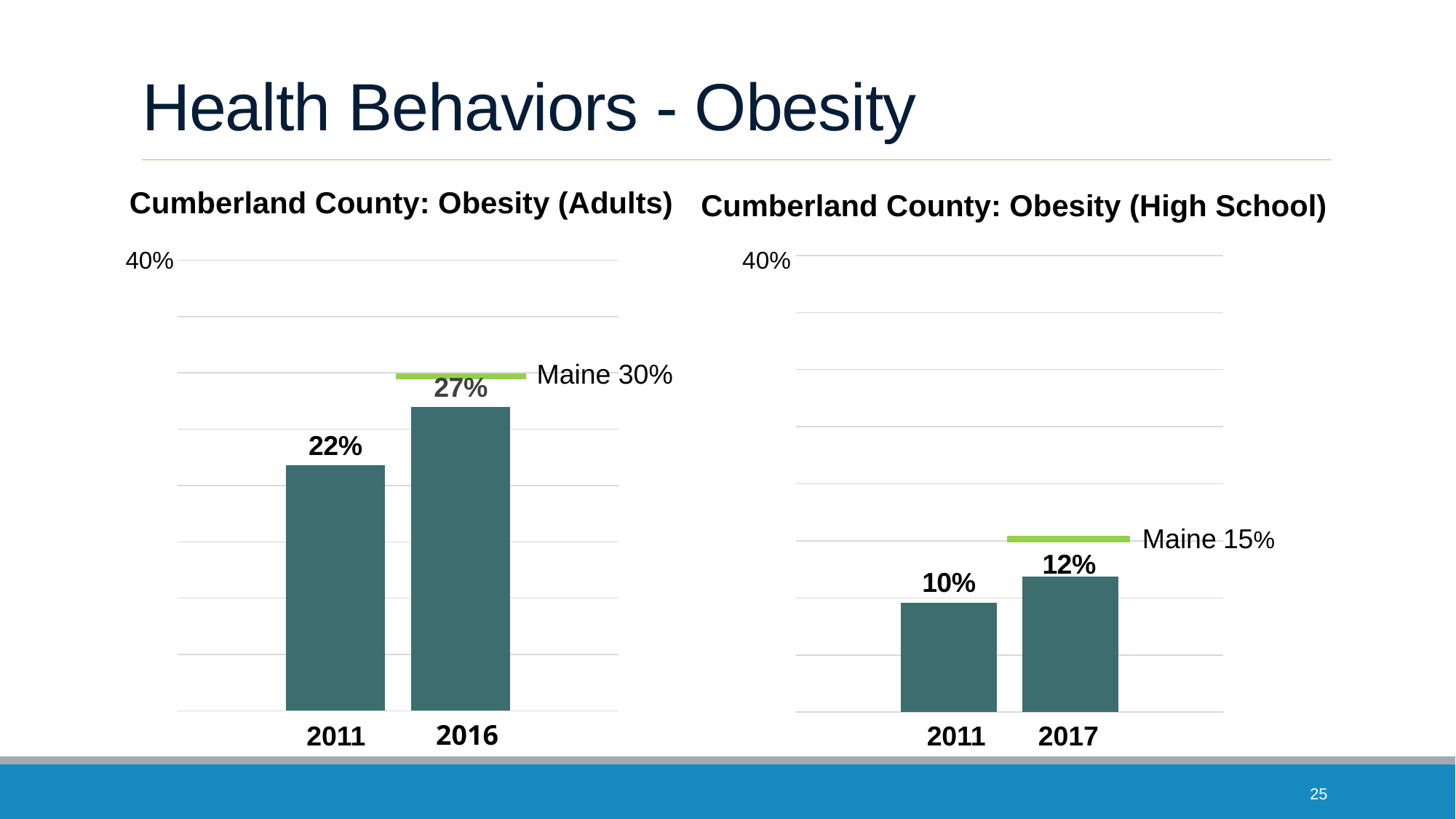
In the 'Cumberland County: Obesity (Adults)' chart, what is the value for 2016? 27% In the 'Cumberland County: Obesity (Adults)' chart, what is the Maine reference value shown? 30% In the 'Cumberland County: Obesity (High School)' chart, which year has the lower value? 2011 In the 'Cumberland County: Obesity (Adults)' chart, which year has the higher value? 2016 In the 'Cumberland County: Obesity (Adults)' chart, what is the value for 2011? 22% In the 'Cumberland County: Obesity (Adults)' chart, what is the difference between the 2016 and 2011 values? 5% In the 'Cumberland County: Obesity (High School)' chart, what is the value for 2011? 10% In the 'Cumberland County: Obesity (High School)' chart, what is the value for 2017? 12% In the 'Cumberland County: Obesity (High School)' chart, what is the Maine reference value shown? 15% What kind of chart is the 'Cumberland County: Obesity (High School)' chart? bar chart In the 'Cumberland County: Obesity (Adults)' chart, do the values rise or fall from 2011 to 2016? rise In the 'Cumberland County: Obesity (High School)' chart, what is the difference between the 2017 and 2011 values? 2%